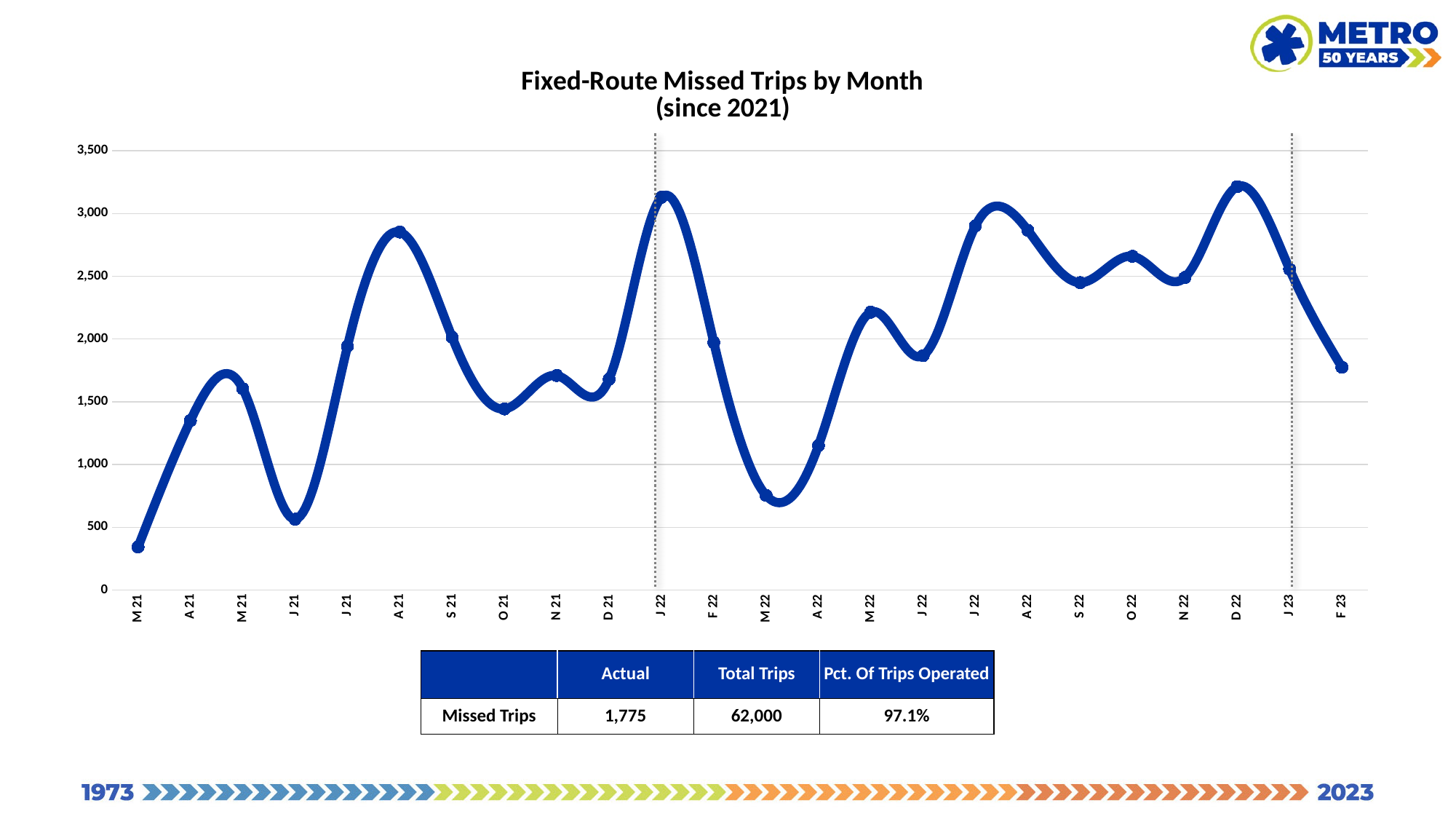
What is the title of the chart? Fixed-Route Missed Trips by Month (since 2021) Is the value for M 21 (the first point) greater or less than 500? less Is the value for F 23 greater or less than 2,000? less Is the value for M 22 (March 2022) greater or less than 1,000? less What kind of chart is shown on the slide? line chart How many monthly data points are plotted on the chart? 24 Which is larger, the value for A 21 (August 2021) or the value for M 21 (May 2021)? A 21 (August 2021) According to the table below the chart, what is the Actual number of Missed Trips? 1,775 Do the values rise or fall from D 22 to F 23? fall Which month has the lowest number of missed trips on the chart? M 21